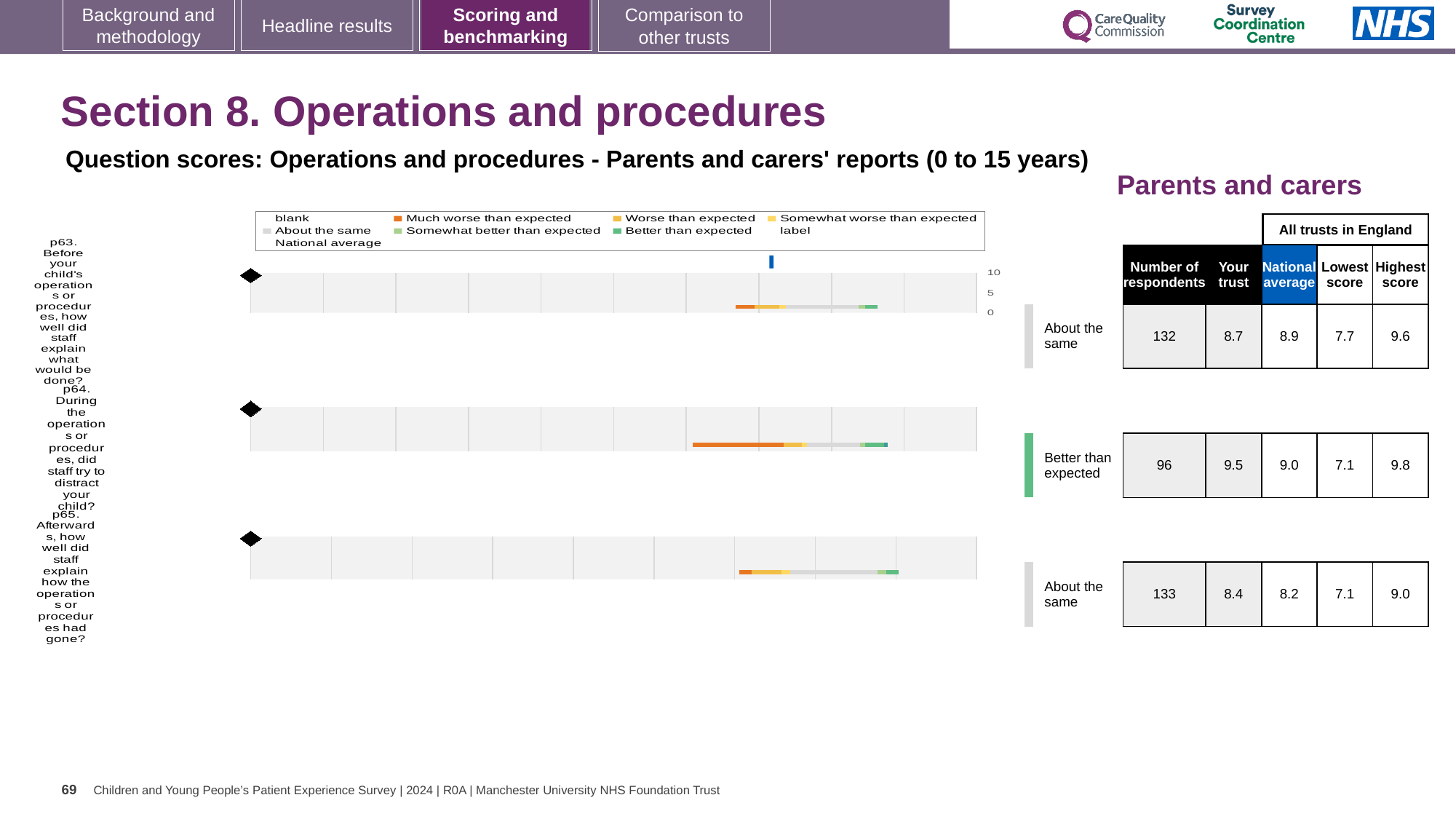
What benchmark category is shown for p64? Better than expected Which question has the lowest 'Your trust' score? p65. Afterwards, how well did staff explain how the operations or procedures had gone? For p64, what is the difference between the 'Your trust' score and the national average? 0.5 What is the lowest score among all trusts in England for p63? 7.7 What is the national average score for p63 (Before your child's operations or procedures, how well did staff explain what would be done?)? 8.9 How many survey questions are plotted on the slide? 3 For p63, which is larger: the 'Your trust' score or the national average? National average What is the highest score among all trusts in England for p64? 9.8 Which question has the highest 'Your trust' score? p64. During the operations or procedures, did staff try to distract your child? How many respondents answered p65? 133 What kind of chart is used to show the question scores? Bar chart What is the 'Your trust' score for p64 (During the operations or procedures, did staff try to distract your child?)? 9.5